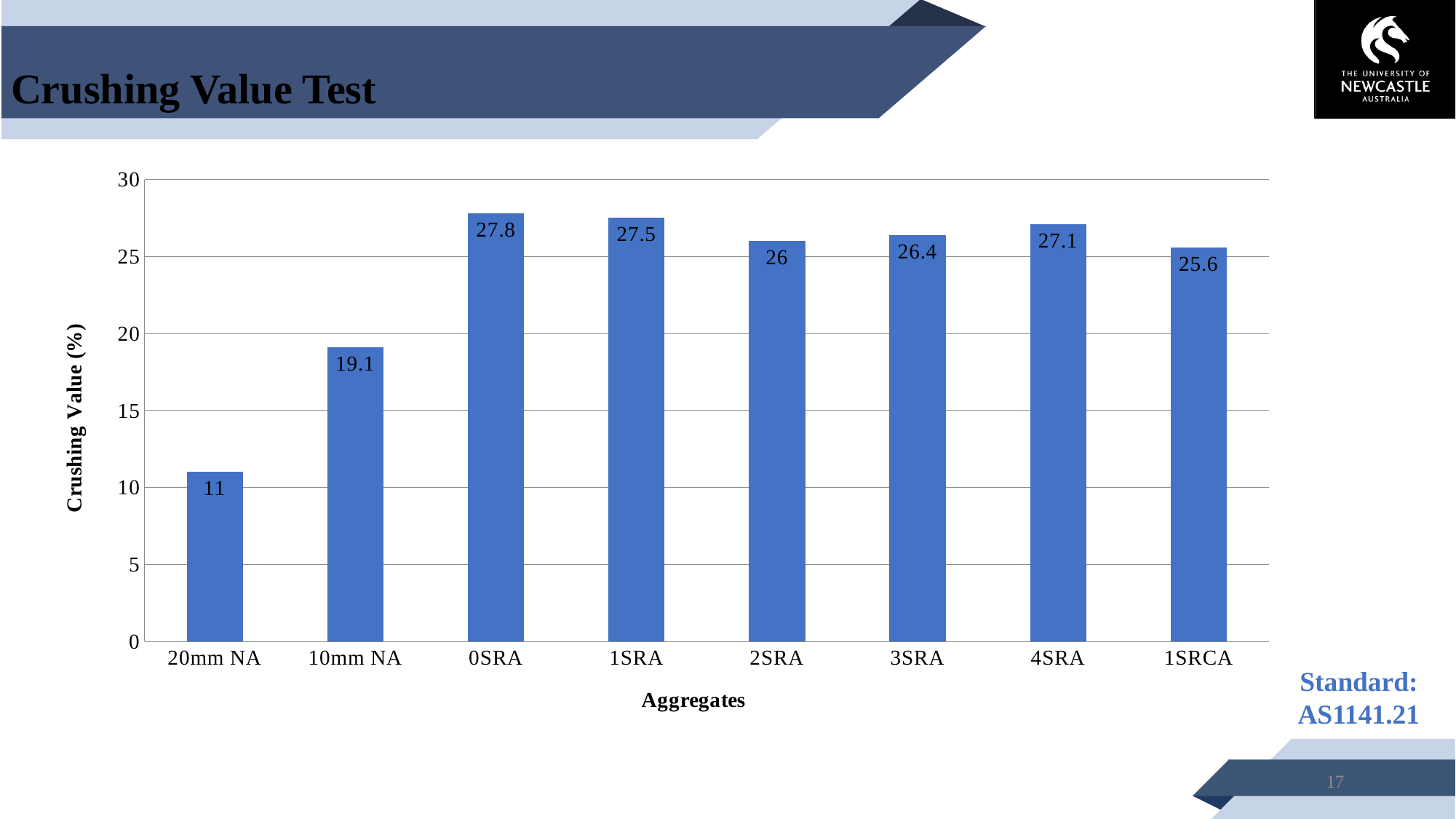
What is the difference between the crushing values of 0SRA and 1SRCA? 2.2 Which has a larger crushing value, 2SRA or 4SRA? 4SRA Is the crushing value for 10mm NA greater or less than 20? less What kind of chart is shown on the slide? bar chart How many aggregates are shown on the x axis? 8 Which aggregate has the highest crushing value? 0SRA What is the difference between the crushing values of 10mm NA and 20mm NA? 8.1 Which aggregate has the lowest crushing value? 20mm NA What is the crushing value for 1SRCA? 25.6 What is the label of the y axis? Crushing Value (%) What is the crushing value for 0SRA? 27.8 What is the crushing value for 20mm NA? 11